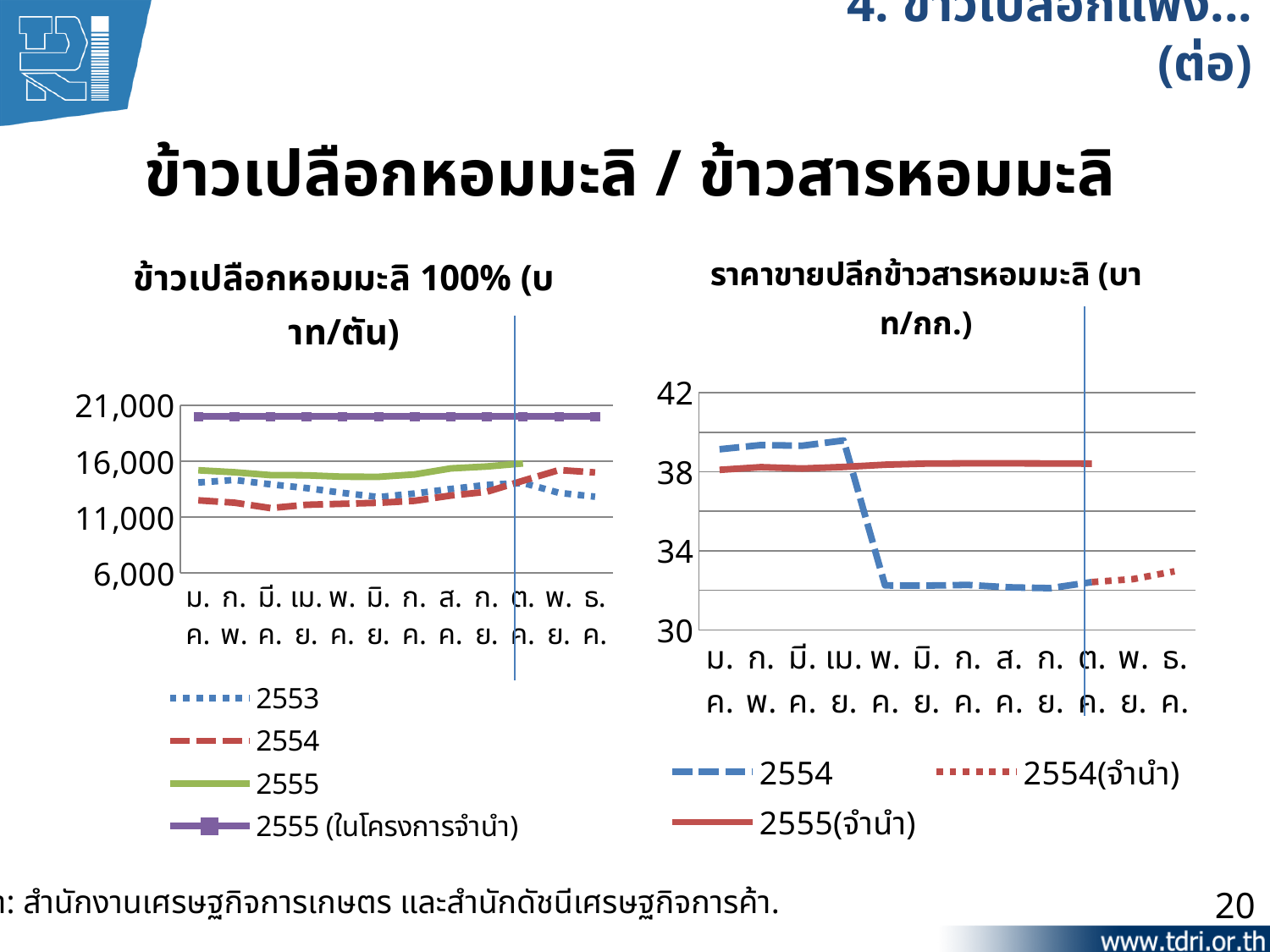
In the right chart (ราคาขายปลีกข้าวสารหอมมะลิ), is the value for 2554 in ก.ค. greater or less than 34? less How many categories (months) are shown on the x axis of the right chart (ราคาขายปลีกข้าวสารหอมมะลิ)? 12 In the right chart (ราคาขายปลีกข้าวสารหอมมะลิ), which series is higher in ก.ค.: 2554 or 2555(จำนำ)? 2555(จำนำ) What kind of chart is the left chart titled ข้าวเปลือกหอมมะลิ 100% (บาท/ตัน)? line chart In the left chart (ข้าวเปลือกหอมมะลิ 100%), is the value for 2554 in ม.ค. greater or less than 16,000? less In the right chart (ราคาขายปลีกข้าวสารหอมมะลิ), is the value for 2554 in ม.ค. greater or less than 38? greater How many series does the legend of the right chart (ราคาขายปลีกข้าวสารหอมมะลิ) list? 3 In the right chart (ราคาขายปลีกข้าวสารหอมมะลิ), does the 2554 line rise or fall from ม.ค. to ต.ค.? fall In the left chart (ข้าวเปลือกหอมมะลิ 100%), does the 2555 (ในโครงการจำนำ) line rise, fall, or stay flat across the months? stay flat In the left chart (ข้าวเปลือกหอมมะลิ 100%), which series is higher in ม.ค.: 2553 or 2555 (ในโครงการจำนำ)? 2555 (ในโครงการจำนำ) How many series does the legend of the left chart (ข้าวเปลือกหอมมะลิ 100%) list? 4